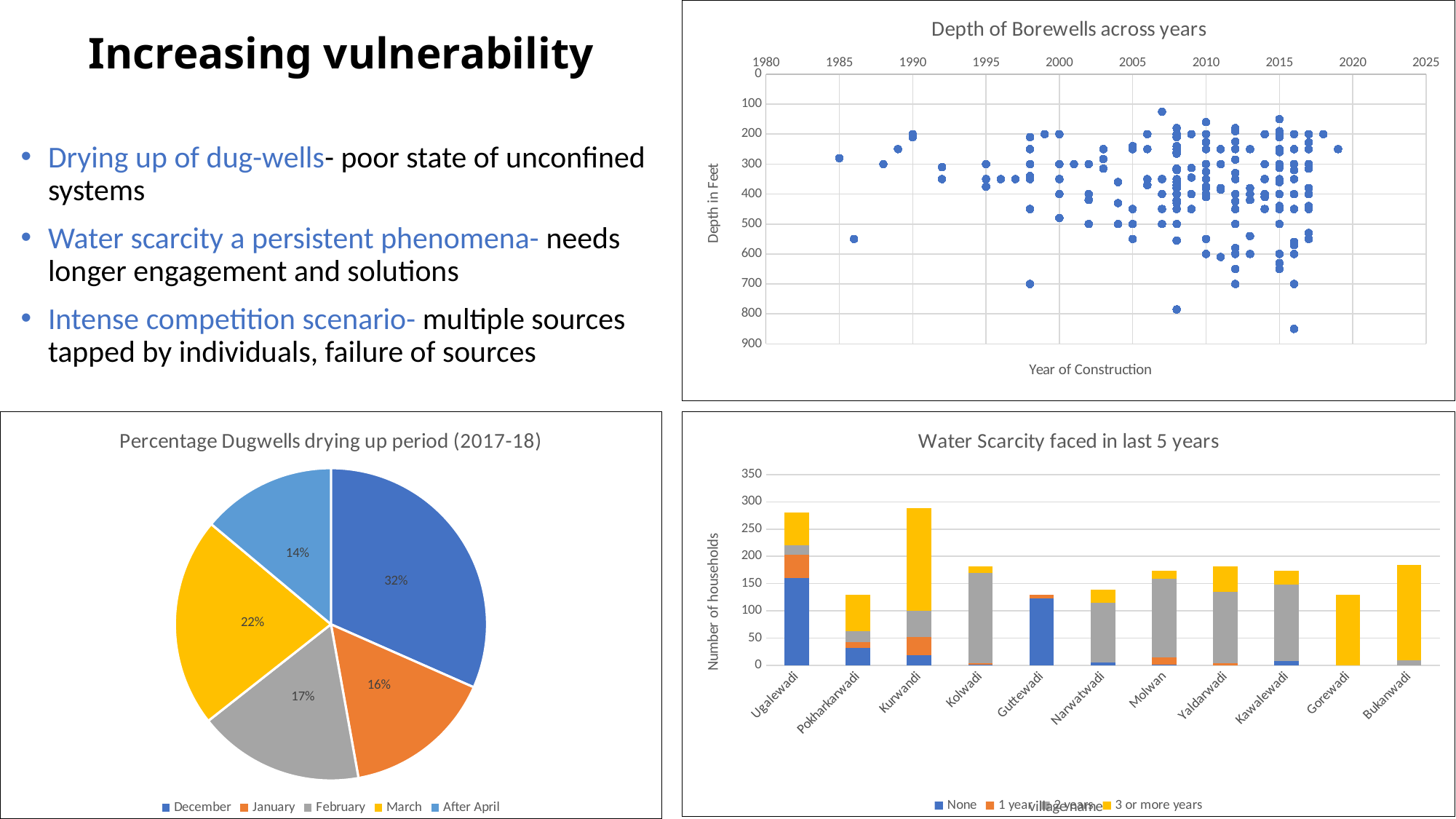
In the pie chart 'Percentage Dugwells drying up period (2017-18)', which period has the smallest share? After April In the chart 'Water Scarcity faced in last 5 years', is the total number of households for Gorewadi greater or less than 150? less In the chart 'Water Scarcity faced in last 5 years', is the total number of households for Ugalewadi greater or less than 250? greater What kind of chart is 'Depth of Borewells across years'? scatter chart How many villages are shown on the x axis of the chart 'Water Scarcity faced in last 5 years'? 11 In the pie chart 'Percentage Dugwells drying up period (2017-18)', what percentage of dugwells dry up in December? 32% In the pie chart 'Percentage Dugwells drying up period (2017-18)', what share is shown for March? 22% How many slices does the pie chart 'Percentage Dugwells drying up period (2017-18)' have? 5 In the pie chart 'Percentage Dugwells drying up period (2017-18)', which period has the largest share? December How many series does the legend of the chart 'Water Scarcity faced in last 5 years' list? 4 In the pie chart 'Percentage Dugwells drying up period (2017-18)', which is larger, the share for February or the share for January? February In the pie chart 'Percentage Dugwells drying up period (2017-18)', what is the difference in percentage points between December and January? 16